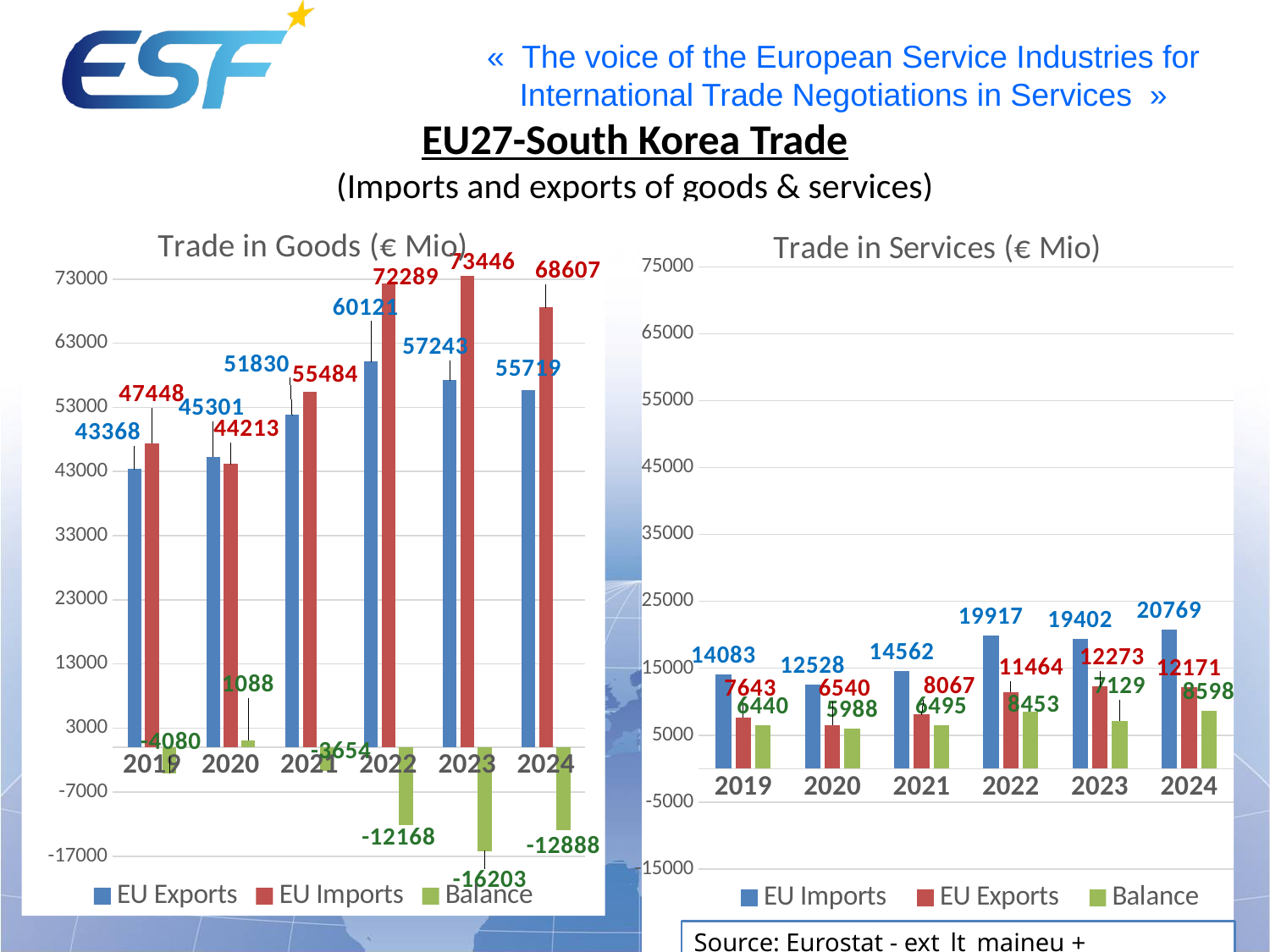
In the Trade in Goods chart, which year has the lowest Balance value? 2023 In the Trade in Services chart, what is the Balance value for 2020? 5988 In the Trade in Goods chart, which is larger in 2020, EU Exports or EU Imports? EU Exports In the Trade in Services chart, which year has the highest EU Imports value? 2024 In the Trade in Services chart, how many series does the legend list? 3 In the Trade in Goods chart, what is the value of EU Imports in 2023? 73446 What kind of chart is the Trade in Services chart? Bar chart How many years are shown on the x axis of the Trade in Goods chart? 6 In the Trade in Goods chart, which year has the highest EU Exports value? 2022 In the Trade in Goods chart, what is the difference between EU Imports and EU Exports in 2022? 12168 In the Trade in Services chart, what is the value of EU Exports in 2023? 12273 In the Trade in Goods chart, what is the value of EU Exports in 2019? 43368